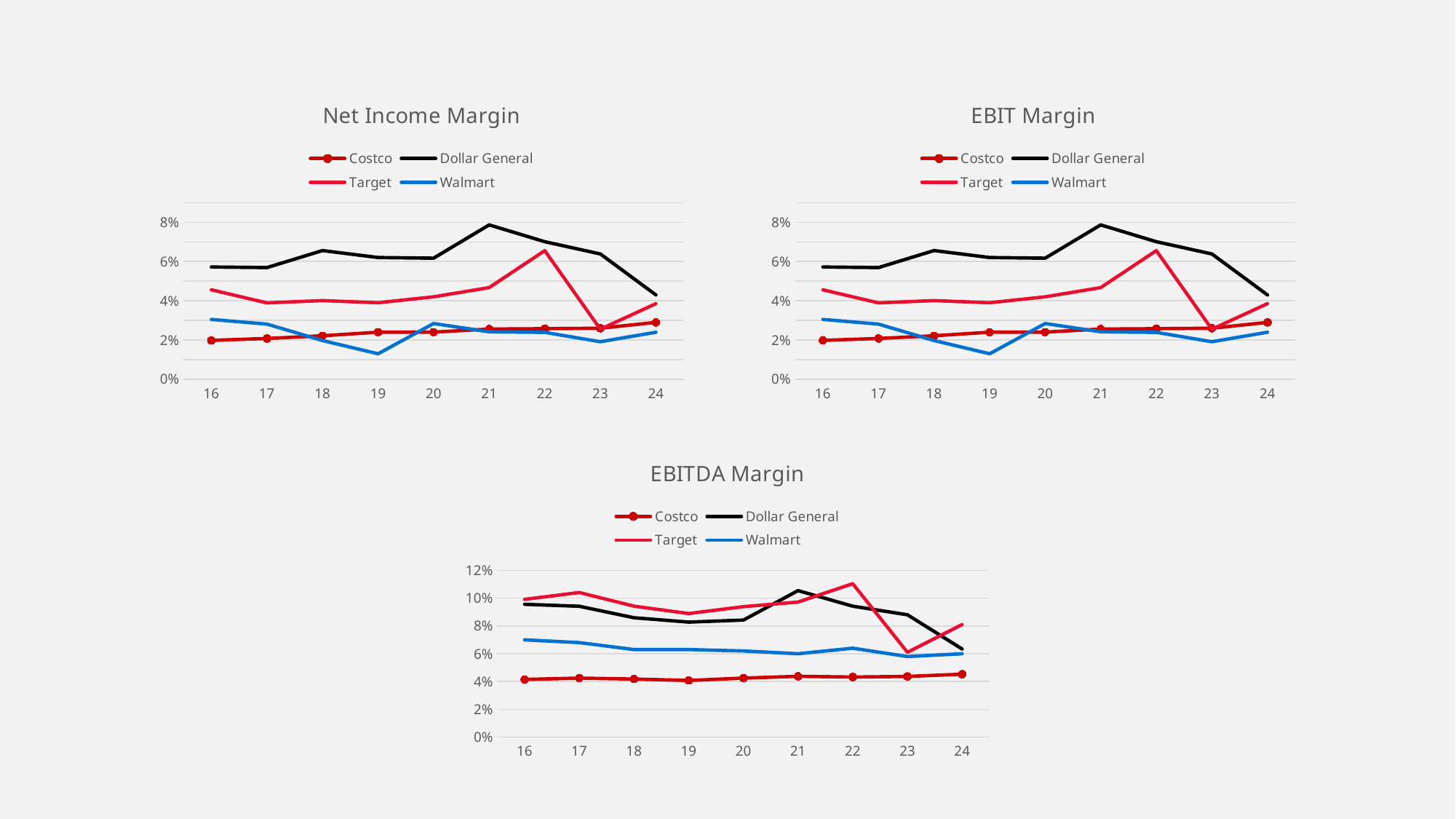
How many series does the legend of the EBITDA Margin chart list? 4 In the EBITDA Margin chart, does the Dollar General line rise or fall from 22 to 24? fall In the Net Income Margin chart, is the value for Dollar General in 21 greater or less than 6%? greater In the Net Income Margin chart, which is larger in 22: Target or Walmart? Target In the EBIT Margin chart, which series has the highest value in 21? Dollar General How many years are plotted along the x axis of the EBIT Margin chart? 9 In the EBITDA Margin chart, which series has the lowest value in 20? Costco In the EBITDA Margin chart, is the value for Costco in 16 greater or less than 6%? less In the EBITDA Margin chart, is the value for Target in 22 greater or less than 10%? greater What kind of chart is the Net Income Margin chart? line chart What is the title of the chart at the bottom of the slide? EBITDA Margin